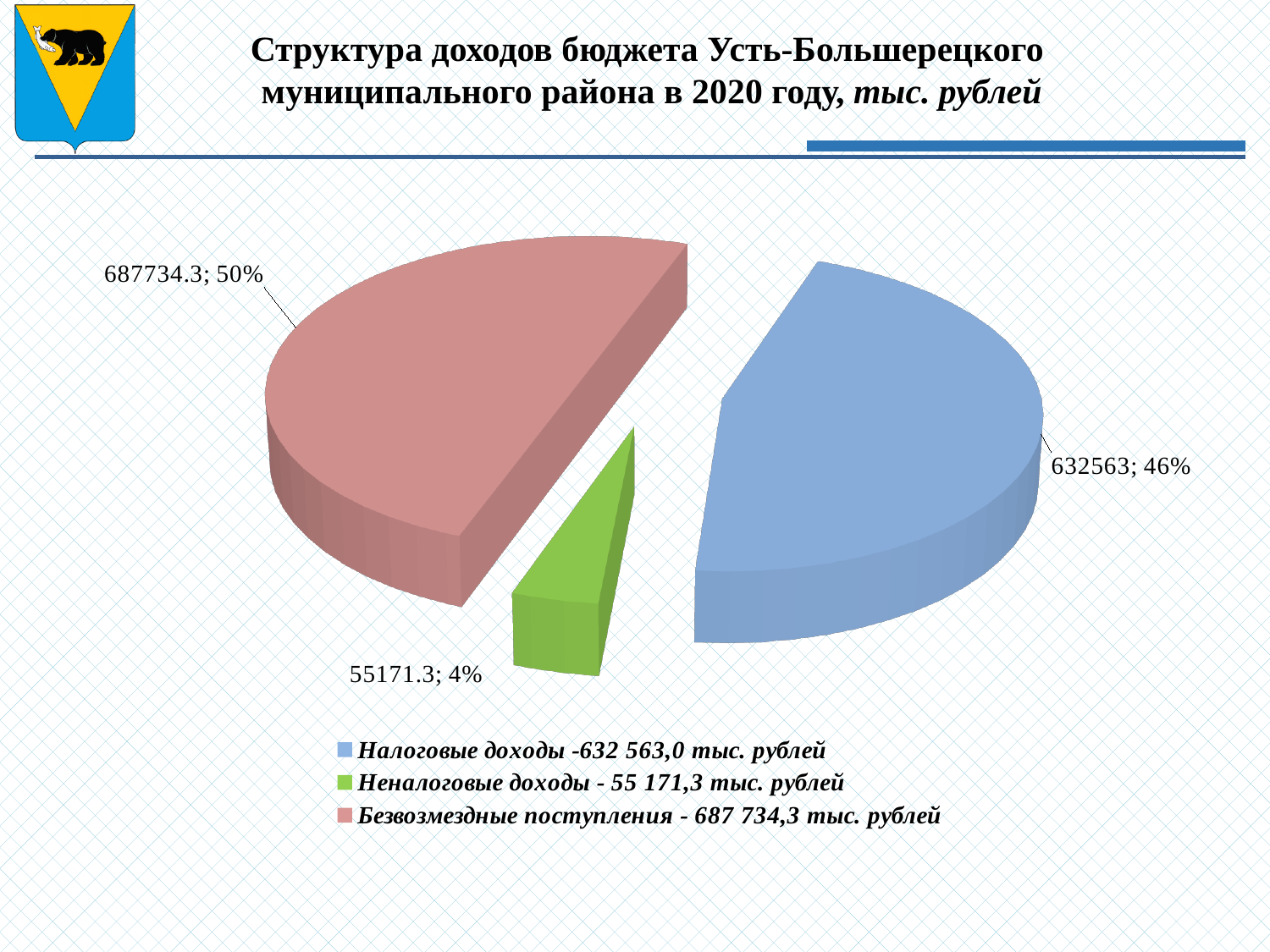
Which category has the largest slice of the pie? Безвозмездные поступления How many slices does the pie chart have? 3 Which category has the smallest slice of the pie? Неналоговые доходы What colour is the slice for Неналоговые доходы? green What share of the pie does Неналоговые доходы represent? 4% What share of the pie does Безвозмездные поступления represent? 50% What value is shown for Неналоговые доходы on the pie chart? 55171.3 What value is shown for Налоговые доходы on the pie chart? 632563 Which is larger: the value for Налоговые доходы or the value for Неналоговые доходы? Налоговые доходы What type of chart is shown on the slide? pie chart What value is shown for Безвозмездные поступления on the pie chart? 687734.3 What is the difference between the values for Безвозмездные поступления and Налоговые доходы? 55171.3